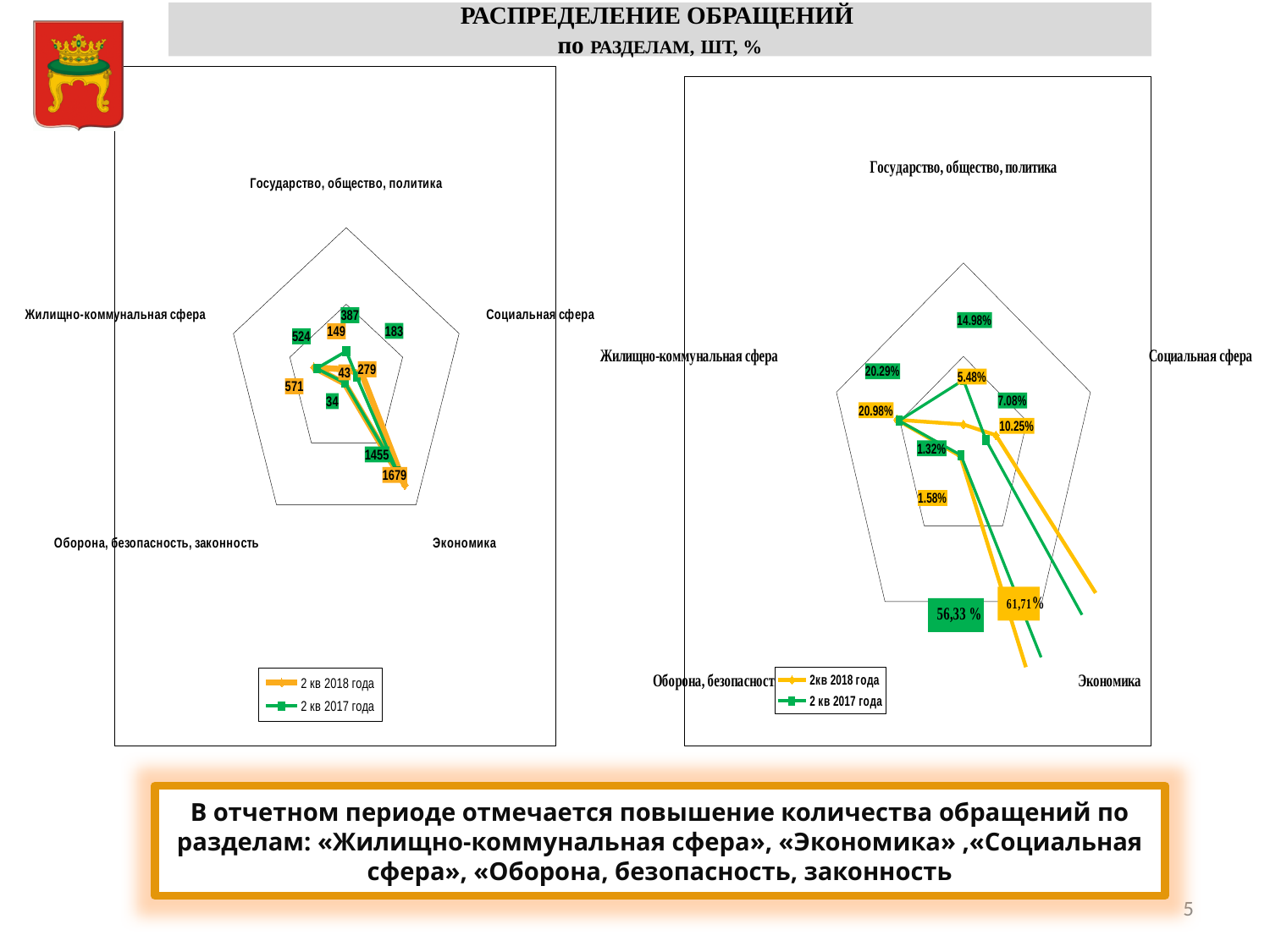
In the left chart, which is larger for Социальная сфера: the 2 кв 2018 года value or the 2 кв 2017 года value? 2 кв 2018 года In the left chart, which category has the highest value for 2 кв 2018 года? Экономика How many categories (axes) does the left radar chart have? 5 In the left chart, what is the value for Государство, общество, политика for 2 кв 2017 года? 387 In the right chart, which category has the lowest value for 2 кв 2018 года? Оборона, безопасность, законность In the right chart, what is the value for Жилищно-коммунальная сфера for 2 кв 2018 года? 20.98% In the left chart, what is the difference between the 2 кв 2018 года and 2 кв 2017 года values for Экономика? 224 In the left chart, which category has the lowest value for 2 кв 2017 года? Оборона, безопасность, законность What type of chart is the left chart on the slide? Radar chart In the right chart, what is the value for Экономика for 2 кв 2017 года? 56,33 % How many series does the legend of the left chart list? 2 In the left chart, what is the value for Экономика for 2 кв 2018 года? 1679